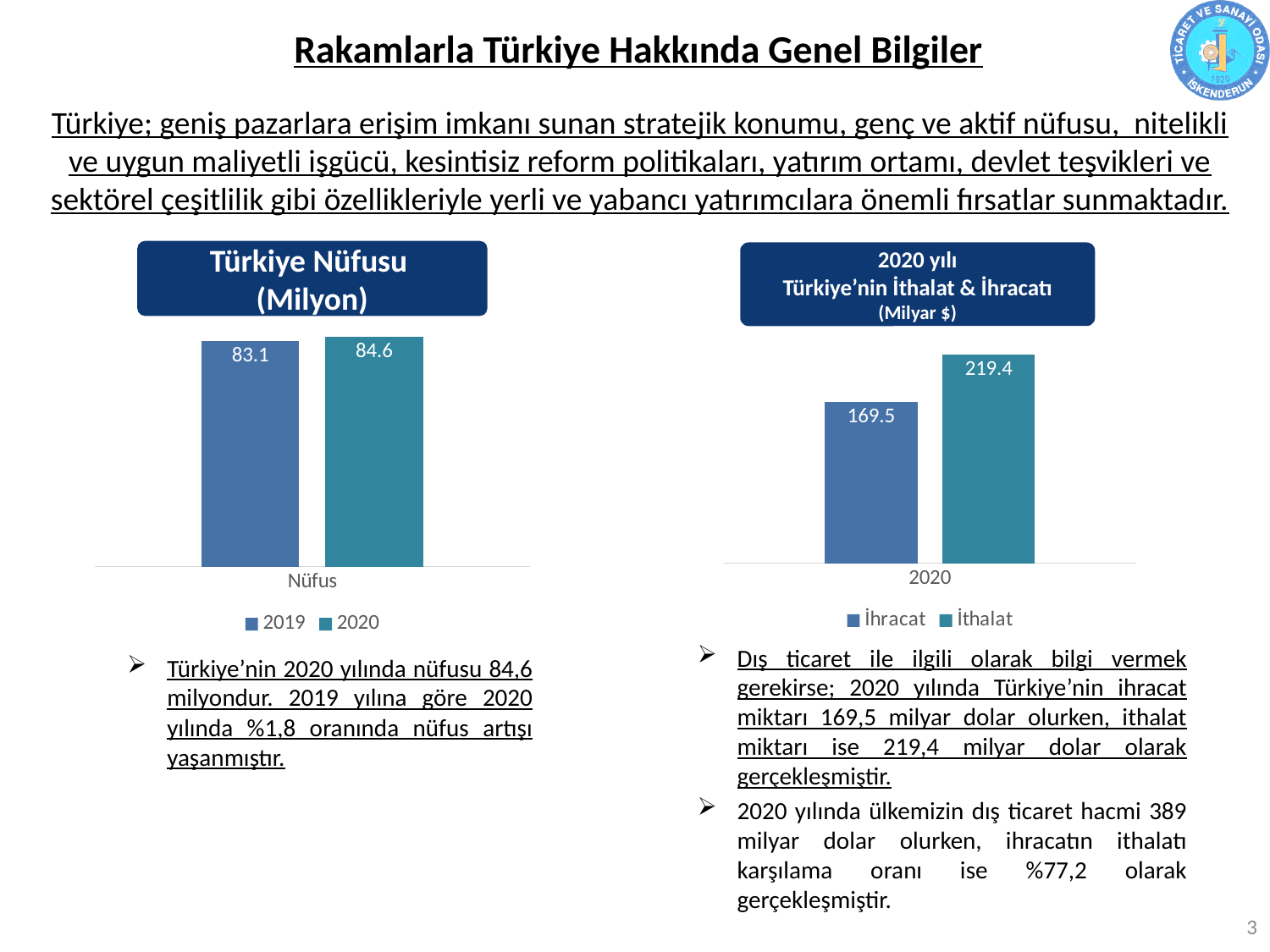
In the '2020 yılı Türkiye'nin İthalat & İhracatı (Milyar $)' chart, which series has the higher value, İhracat or İthalat? İthalat In the '2020 yılı Türkiye'nin İthalat & İhracatı (Milyar $)' chart, what is the category label on the x axis? 2020 In the '2020 yılı Türkiye'nin İthalat & İhracatı (Milyar $)' chart, what is the value for İhracat? 169.5 In the 'Türkiye Nüfusu (Milyon)' chart, what is the value for 2019? 83.1 In the '2020 yılı Türkiye'nin İthalat & İhracatı (Milyar $)' chart, how many series does the legend list? 2 In the 'Türkiye Nüfusu (Milyon)' chart, how many series does the legend list? 2 In the 'Türkiye Nüfusu (Milyon)' chart, what is the category label on the x axis? Nüfus In the '2020 yılı Türkiye'nin İthalat & İhracatı (Milyar $)' chart, what is the value for İthalat? 219.4 In the 'Türkiye Nüfusu (Milyon)' chart, what is the difference between the 2020 and 2019 values? 1.5 In the '2020 yılı Türkiye'nin İthalat & İhracatı (Milyar $)' chart, what is the difference between İthalat and İhracat? 49.9 In the 'Türkiye Nüfusu (Milyon)' chart, what kind of chart is shown? Bar chart In the 'Türkiye Nüfusu (Milyon)' chart, what is the value for 2020? 84.6